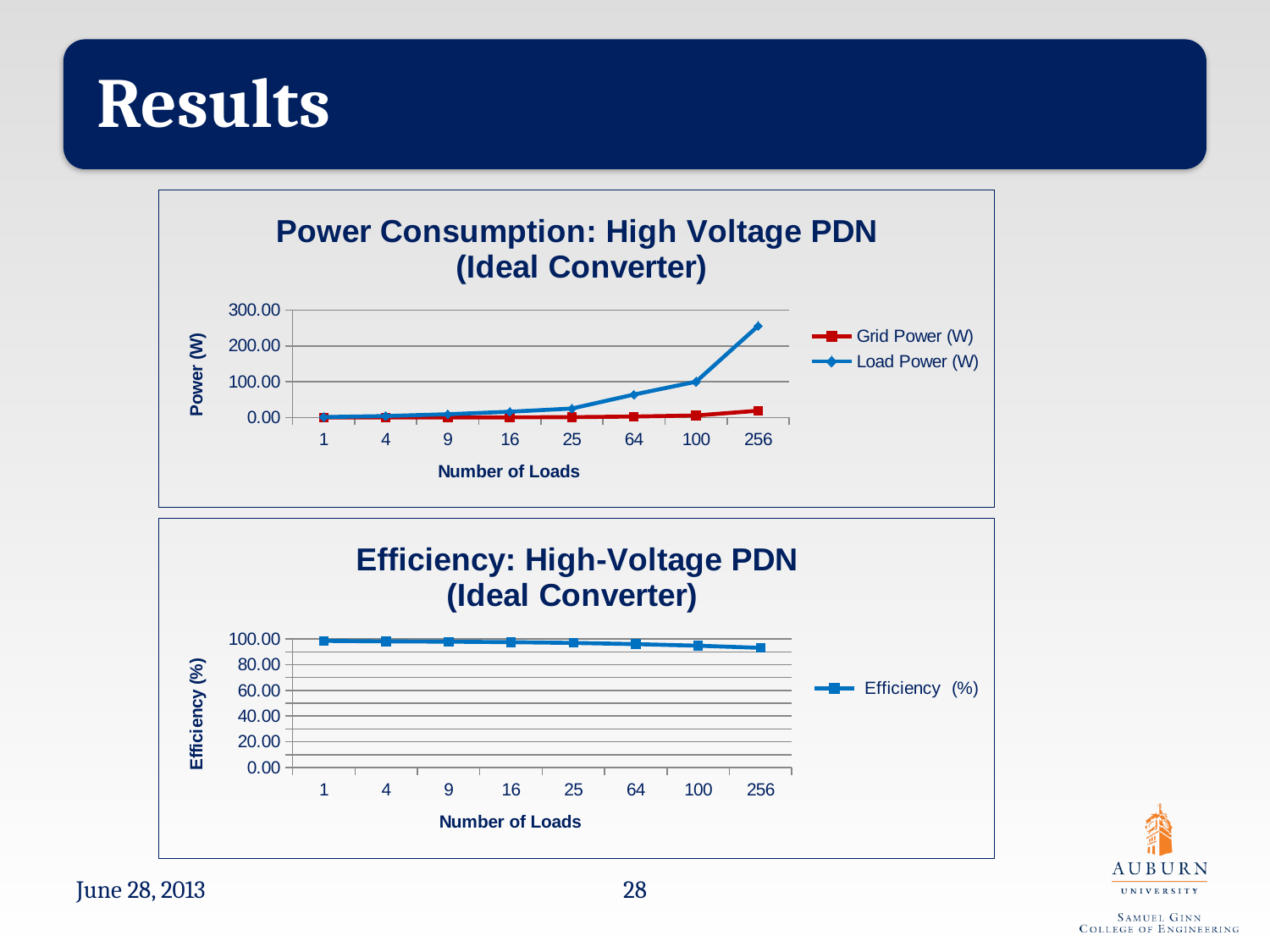
How many Number of Loads categories are shown on the x axis of the 'Power Consumption: High Voltage PDN (Ideal Converter)' chart? 8 In the 'Efficiency: High-Voltage PDN (Ideal Converter)' chart, is the Efficiency (%) value at 256 loads greater or less than 80.00? greater In the 'Power Consumption: High Voltage PDN (Ideal Converter)' chart, is the Load Power (W) value at 256 loads greater or less than 200.00? greater What kind of chart is the 'Efficiency: High-Voltage PDN (Ideal Converter)' chart? Line chart What kind of chart is the 'Power Consumption: High Voltage PDN (Ideal Converter)' chart? Line chart In the 'Power Consumption: High Voltage PDN (Ideal Converter)' chart, at which Number of Loads is Load Power (W) highest? 256 How many series does the legend of the 'Power Consumption: High Voltage PDN (Ideal Converter)' chart list? 2 In the 'Power Consumption: High Voltage PDN (Ideal Converter)' chart, is the Grid Power (W) value at 256 loads greater or less than 100.00? less In the 'Efficiency: High-Voltage PDN (Ideal Converter)' chart, does Efficiency (%) rise or fall as the Number of Loads increases? Fall In the 'Power Consumption: High Voltage PDN (Ideal Converter)' chart, which series is larger at 256 loads, Grid Power (W) or Load Power (W)? Load Power (W) What is the y-axis label of the 'Efficiency: High-Voltage PDN (Ideal Converter)' chart? Efficiency (%) In the 'Power Consumption: High Voltage PDN (Ideal Converter)' chart, does Load Power (W) rise or fall as the Number of Loads increases? Rise